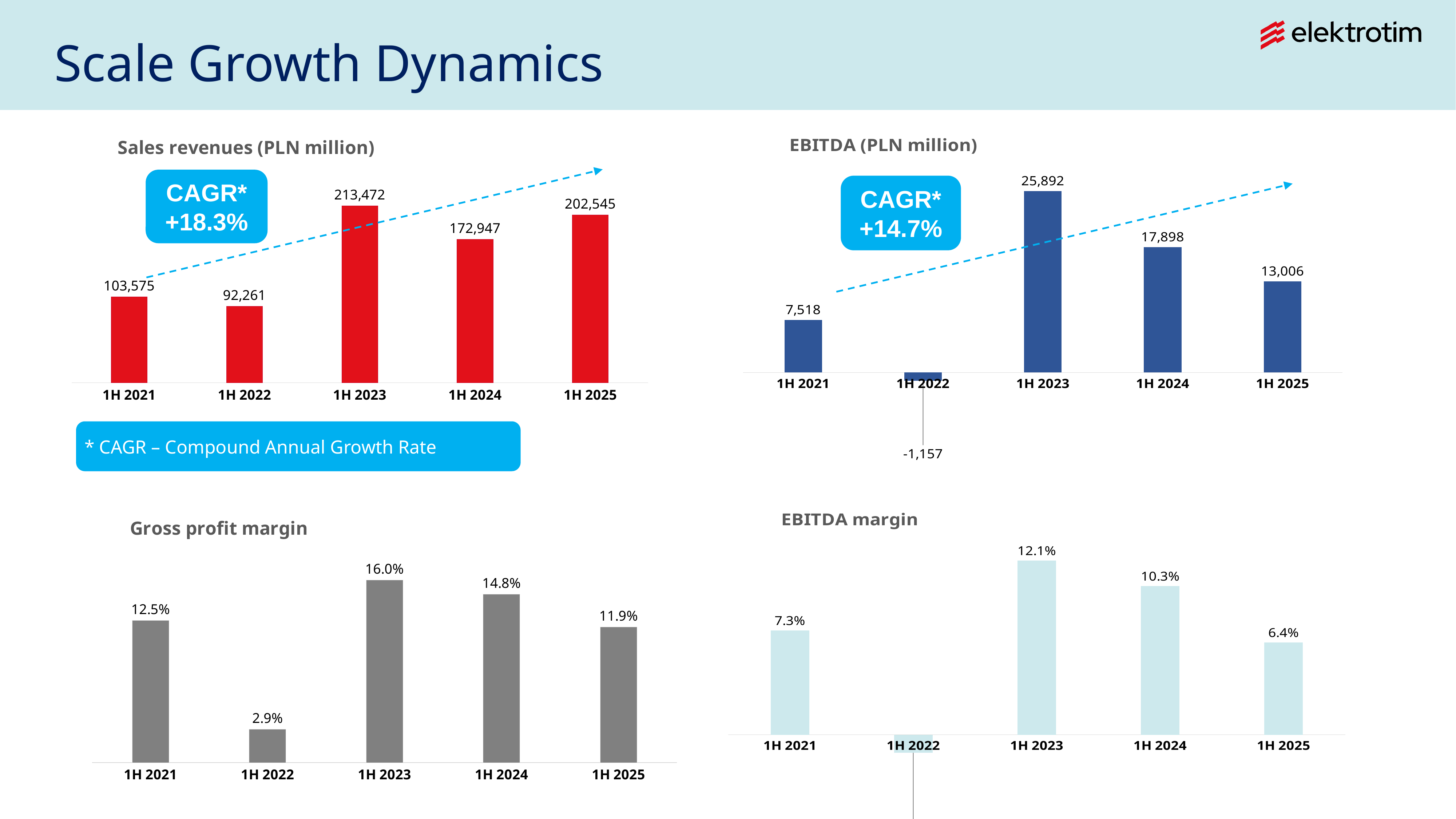
In the Sales revenues (PLN million) chart, what is the value for 1H 2023? 213,472 In the Sales revenues (PLN million) chart, what is the difference between 1H 2025 and 1H 2024? 29,598 In the Gross profit margin chart, what is the value for 1H 2022? 2.9% What CAGR is shown in the box on the EBITDA (PLN million) chart? +14.7% How many periods are shown on the x axis of the Sales revenues (PLN million) chart? 5 In the EBITDA (PLN million) chart, which period has the highest value? 1H 2023 In the EBITDA margin chart, which is larger, 1H 2021 or 1H 2025? 1H 2021 In the Sales revenues (PLN million) chart, which period has the lowest value? 1H 2022 In the EBITDA margin chart, what is the value for 1H 2024? 10.3% In the EBITDA (PLN million) chart, what is the value for 1H 2022? -1,157 In the Gross profit margin chart, what is the difference between 1H 2023 and 1H 2024? 1.2% In the EBITDA (PLN million) chart, which is larger, 1H 2021 or 1H 2025? 1H 2025